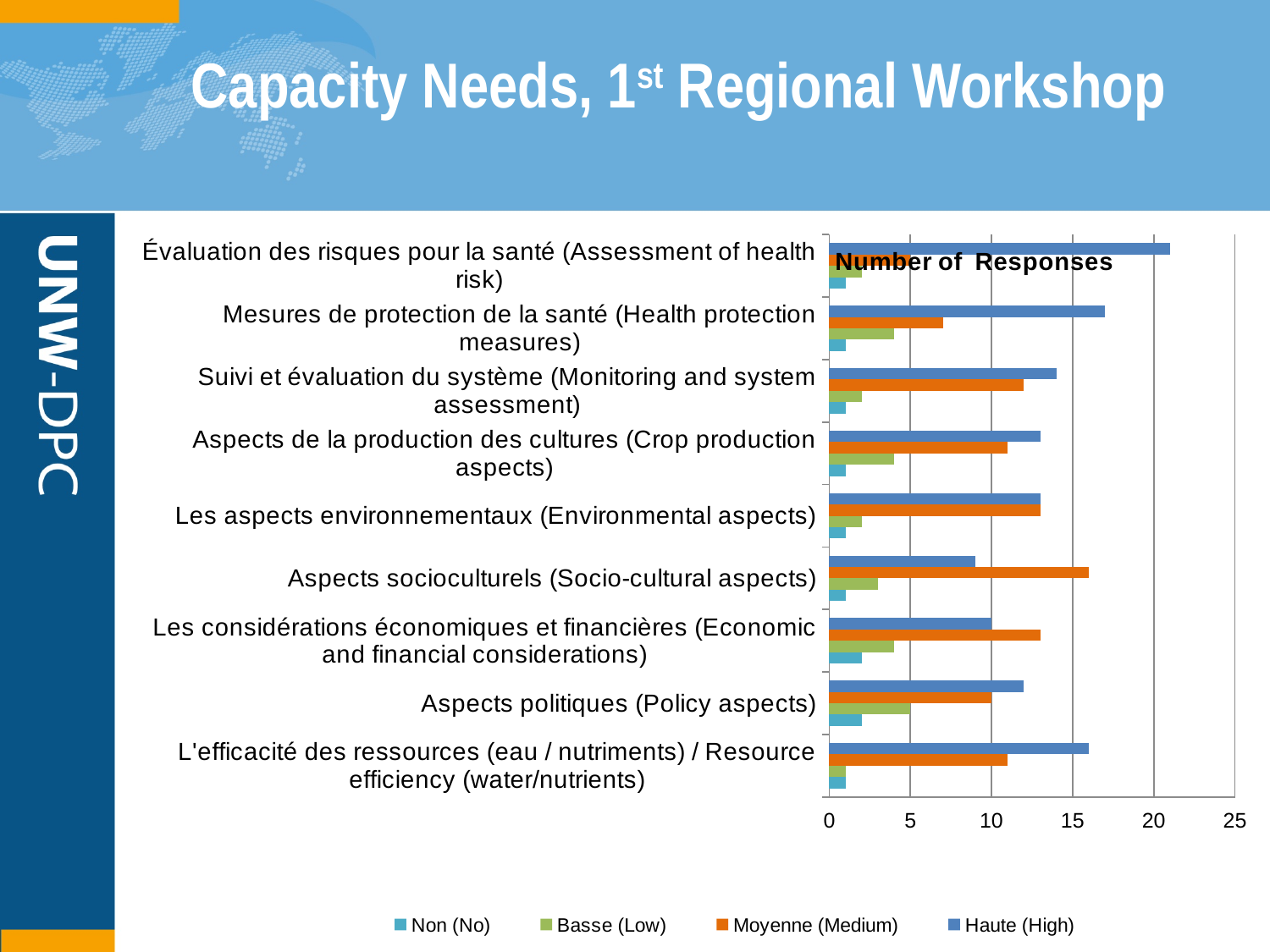
For Mesures de protection de la santé (Health protection measures), which is larger: the Haute (High) value or the Moyenne (Medium) value? Haute (High) Which category has the highest Haute (High) value? Évaluation des risques pour la santé (Assessment of health risk) Is the Haute (High) value for Mesures de protection de la santé (Health protection measures) greater or less than 15? greater Is the Haute (High) value for Évaluation des risques pour la santé (Assessment of health risk) greater or less than 20? greater Which series is shown in orange in the legend? Moyenne (Medium) What is the title of the chart? Number of Responses Is the Moyenne (Medium) value for Évaluation des risques pour la santé (Assessment of health risk) greater or less than 10? less How many categories are plotted on the chart? 9 What kind of chart is shown on the slide? Bar chart For Aspects socioculturels (Socio-cultural aspects), which is larger: the Moyenne (Medium) value or the Haute (High) value? Moyenne (Medium) How many series does the legend list? 4